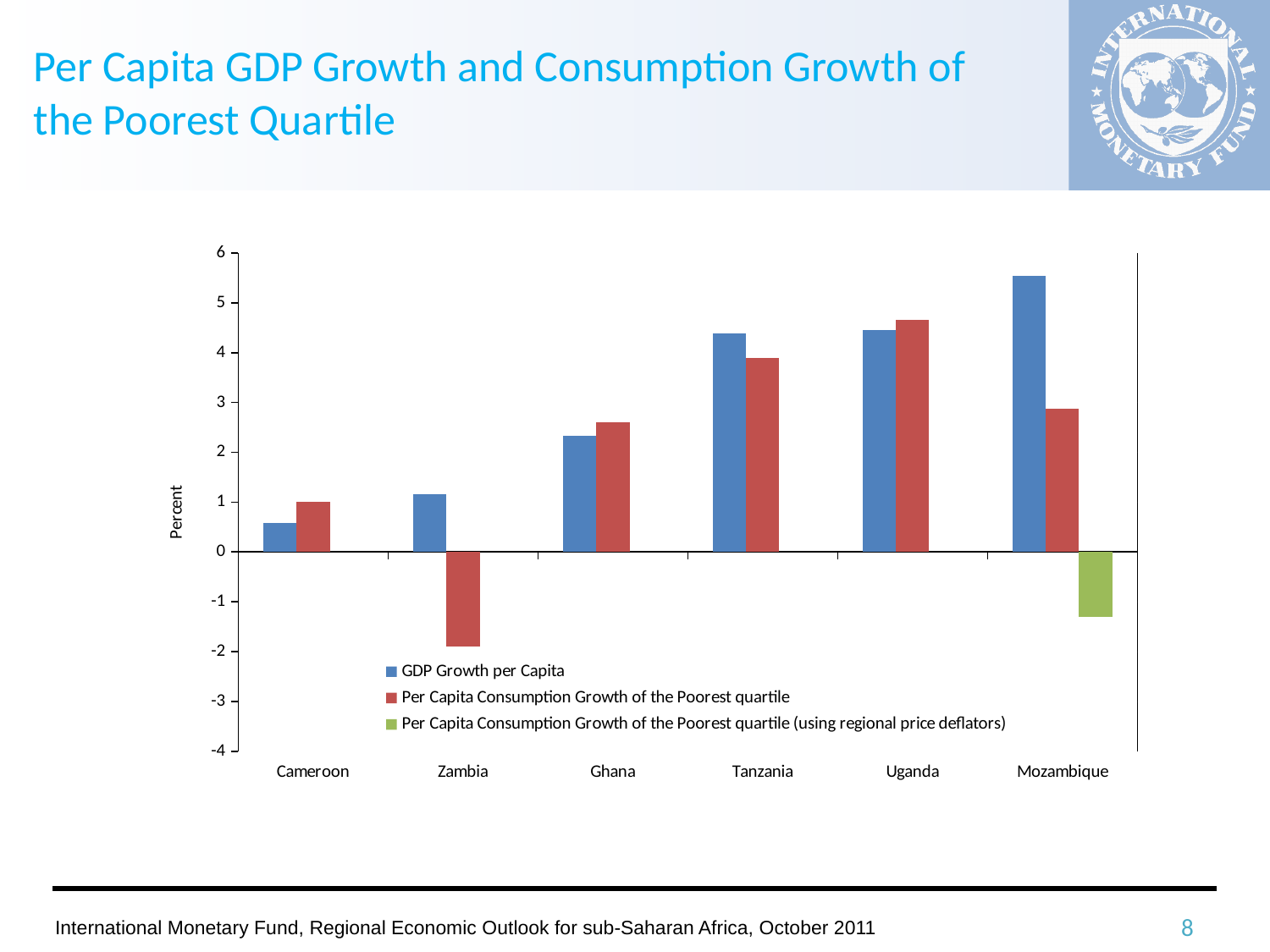
How many series does the chart's legend list? 3 What is the label on the chart's vertical axis? Percent For Tanzania, which is larger: GDP Growth per Capita or Per Capita Consumption Growth of the Poorest quartile? GDP Growth per Capita Which country has the lowest GDP Growth per Capita? Cameroon Is the GDP Growth per Capita for Mozambique greater or less than 5? greater How many countries are shown on the x axis of the chart? 6 Which country has the highest Per Capita Consumption Growth of the Poorest quartile? Uganda Which country has the lowest Per Capita Consumption Growth of the Poorest quartile? Zambia Is the GDP Growth per Capita for Cameroon greater or less than 1? less What kind of chart is shown on the slide? bar chart Is the Per Capita Consumption Growth of the Poorest quartile for Zambia greater or less than -1? less Which country has the highest GDP Growth per Capita? Mozambique